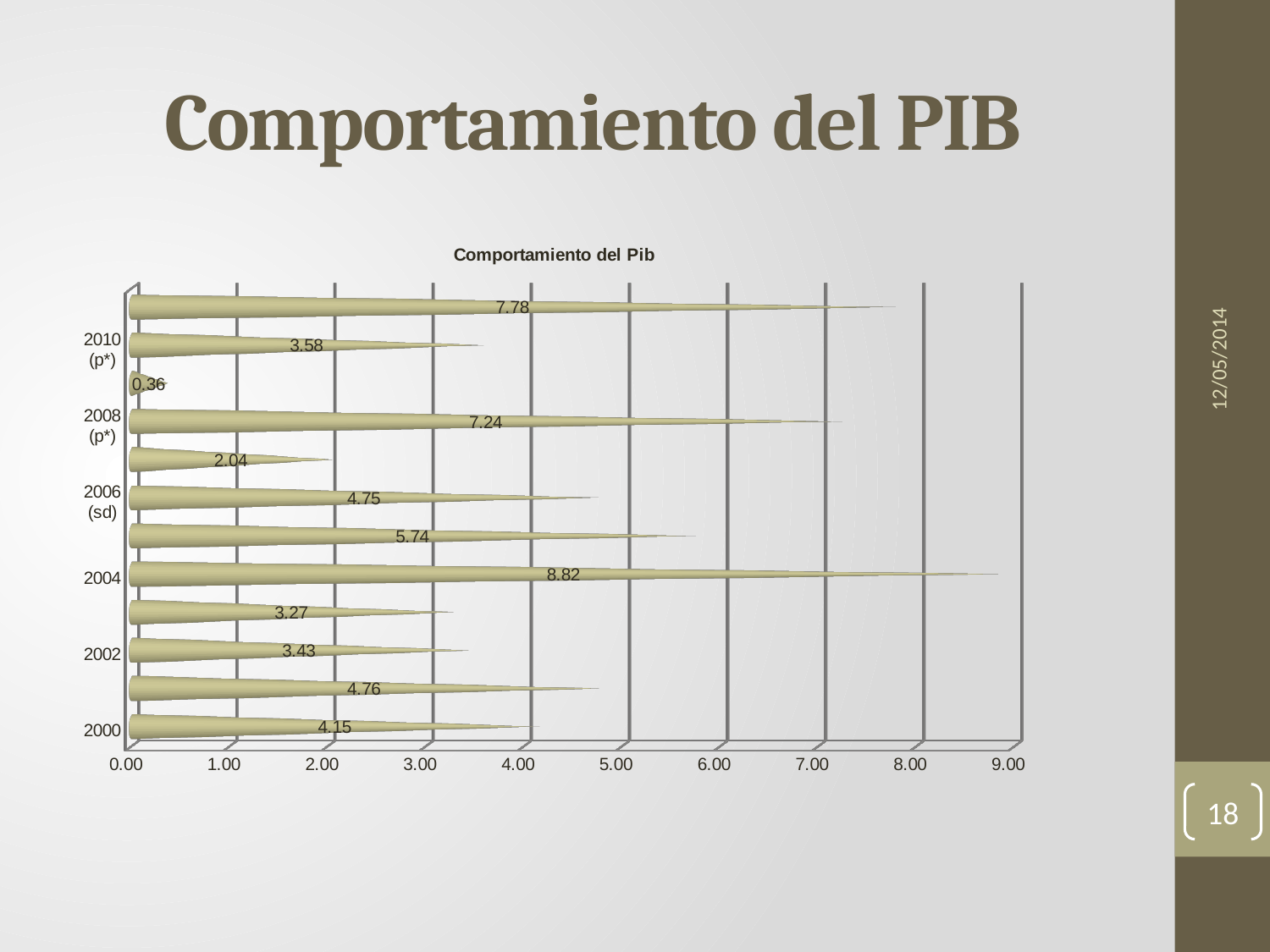
What is the value for 2010 (p*)? 3.58 What is the value for 2008 (p*)? 7.24 What is the difference between the values for 2004 and 2008 (p*)? 1.58 Which is larger, the value for 2000 or the value for 2010 (p*)? 2000 What is the title of the chart? Comportamiento del Pib Which labeled year has the highest value? 2004 What is the value for 2004? 8.82 What is the value for 2002? 3.43 What type of chart is shown on the slide? bar chart What is the value for 2000? 4.15 What is the value for 2006 (sd)? 4.75 What is the lowest value shown on the chart? 0.36